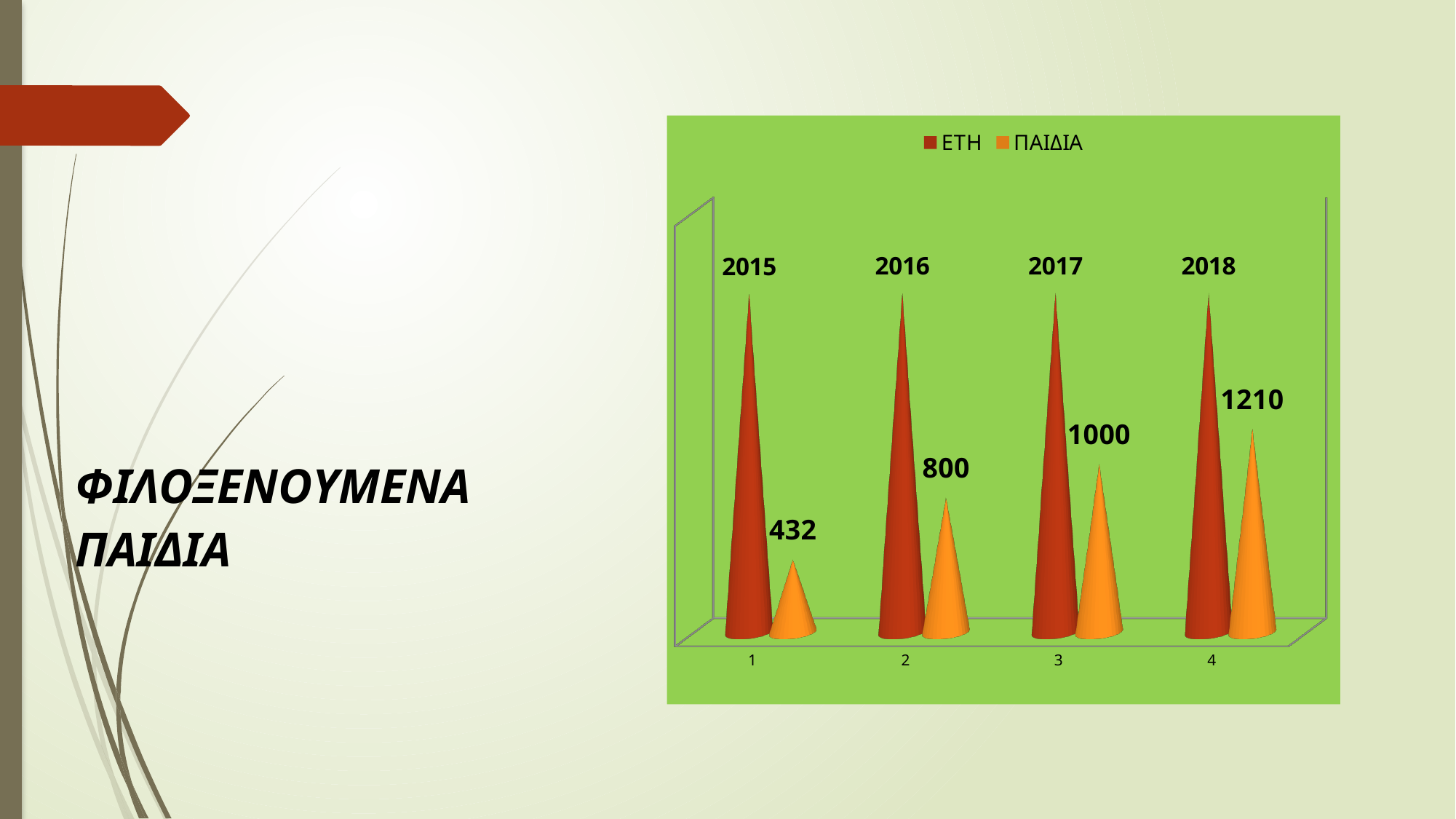
Which category has the lowest ΠΑΙΔΙΑ value? 1 How many series does the legend list? 2 What is the ΠΑΙΔΙΑ value for category 1? 432 What is the difference between the ΠΑΙΔΙΑ values for category 4 and category 1? 778 Which category has the highest ΠΑΙΔΙΑ value? 4 What is the ΠΑΙΔΙΑ value for category 4? 1210 What is the ΕΤΗ value labelled for category 3? 2017 What kind of chart is shown on the slide? bar chart How many categories are shown on the x axis? 4 Do the ΠΑΙΔΙΑ values rise or fall from category 1 to category 4? rise Which is larger, the ΠΑΙΔΙΑ value for category 2 or for category 3? category 3 What is the ΠΑΙΔΙΑ value for category 2? 800